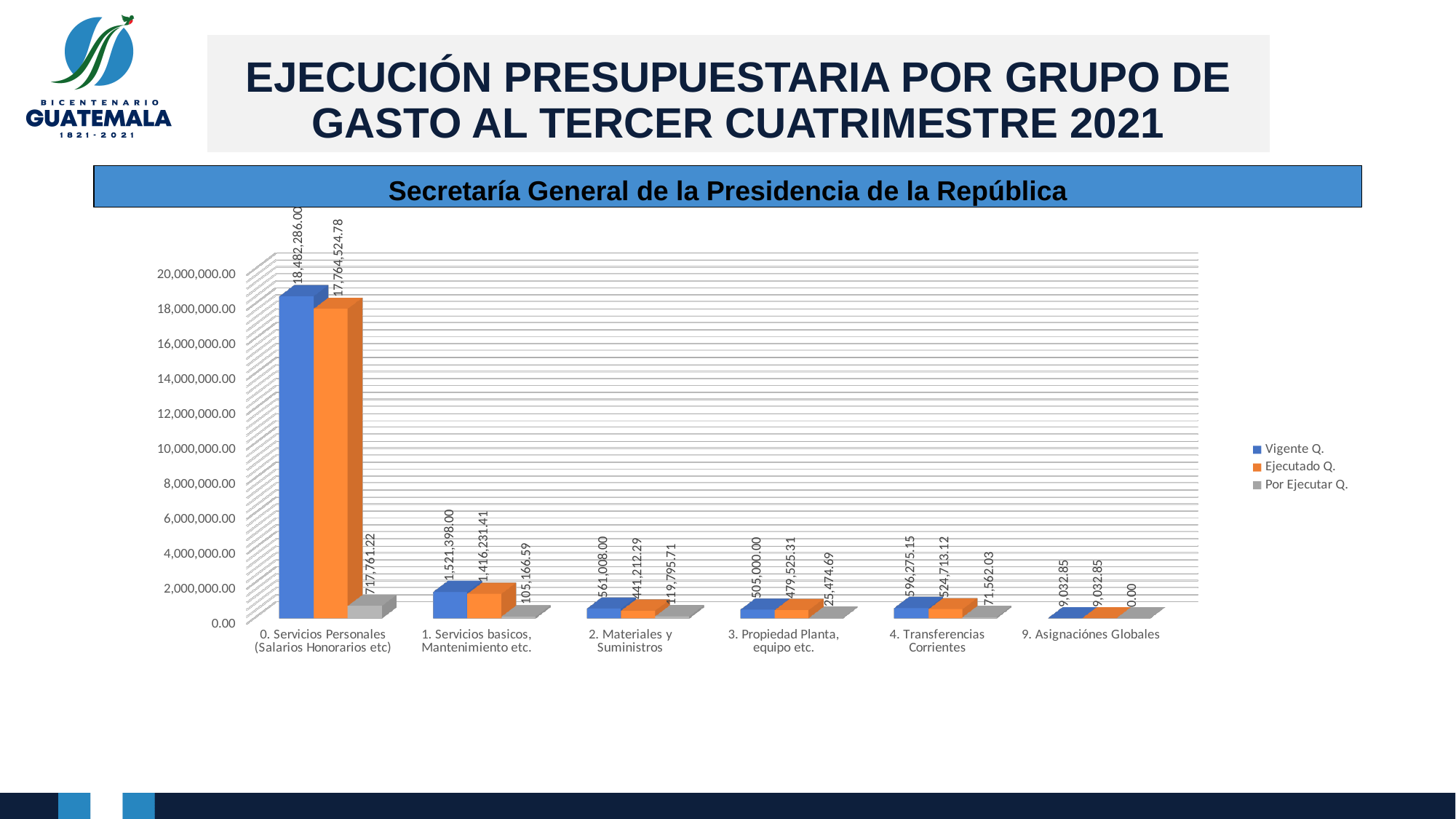
Which category has the lowest Ejecutado Q. value? 9. Asignaciónes Globales Which category has the highest Vigente Q. value? 0. Servicios Personales (Salarios Honorarios etc) What kind of chart is shown on the slide? bar chart What is the Vigente Q. value for 0. Servicios Personales (Salarios Honorarios etc)? 18,482,286.00 Is the Ejecutado Q. value for 0. Servicios Personales (Salarios Honorarios etc) greater or less than 16,000,000.00? greater What is the difference between the Vigente Q. and Ejecutado Q. values for 0. Servicios Personales (Salarios Honorarios etc)? 717,761.22 How many expense group categories are shown on the x axis? 6 Which is larger: the Vigente Q. value for 4. Transferencias Corrientes or for 2. Materiales y Suministros? 4. Transferencias Corrientes How many series does the legend list? 3 What is the Por Ejecutar Q. value for 9. Asignaciónes Globales? 0.00 What is the Por Ejecutar Q. value for 2. Materiales y Suministros? 119,795.71 What is the Ejecutado Q. value for 1. Servicios basicos, Mantenimiento etc.? 1,416,231.41